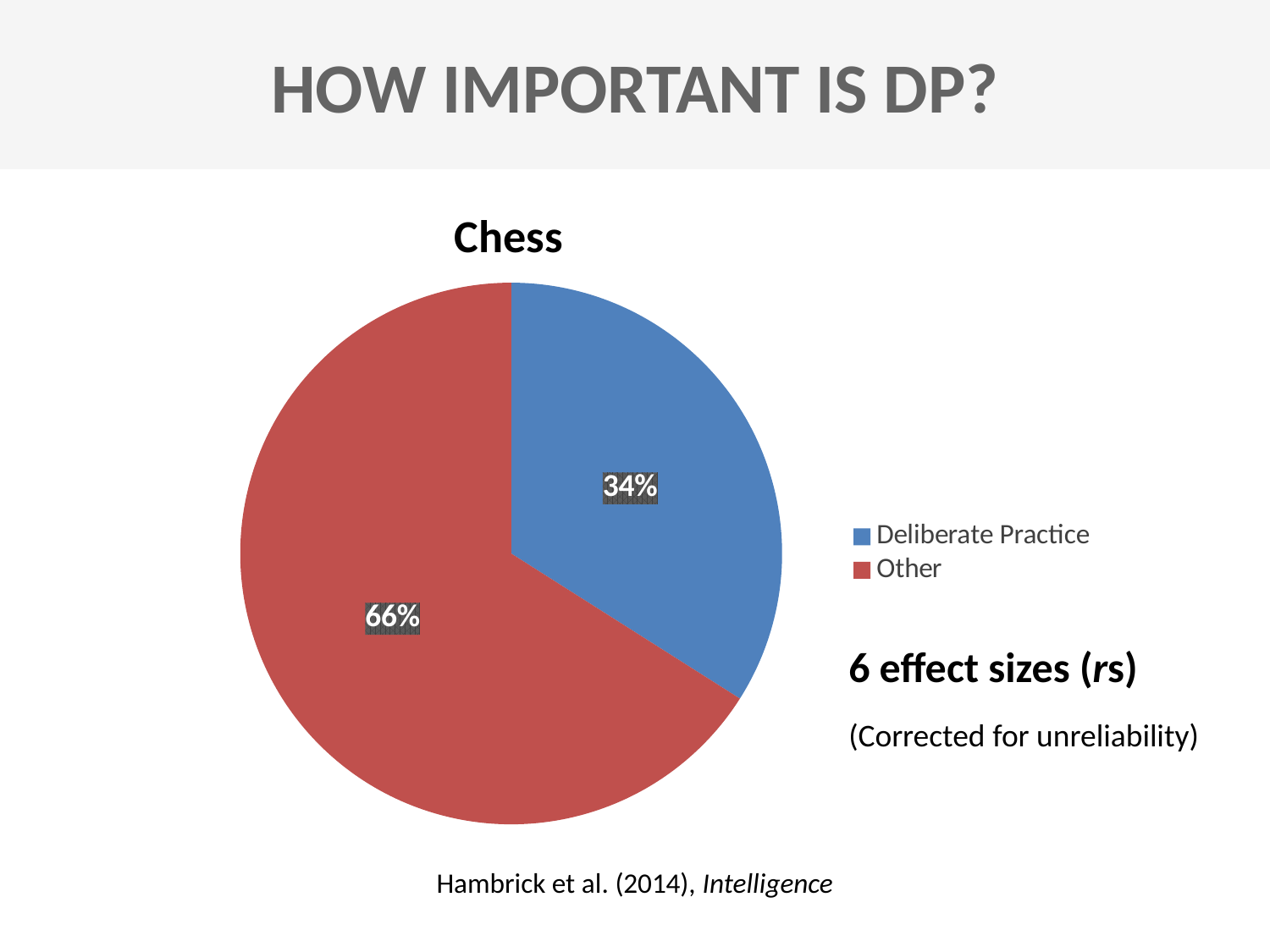
Which slice is the largest? Other What kind of chart is shown on the slide? pie chart Which is larger, the Deliberate Practice slice or the Other slice? Other What share of the pie does Deliberate Practice account for? 34% How many slices does the pie chart have? 2 What is the chart's title? Chess Which slice is the smallest? Deliberate Practice What share of the pie does Other account for? 66% What is the difference in percentage points between the Other slice and the Deliberate Practice slice? 32 How many entries does the legend list? 2 What colour is the Deliberate Practice slice? blue